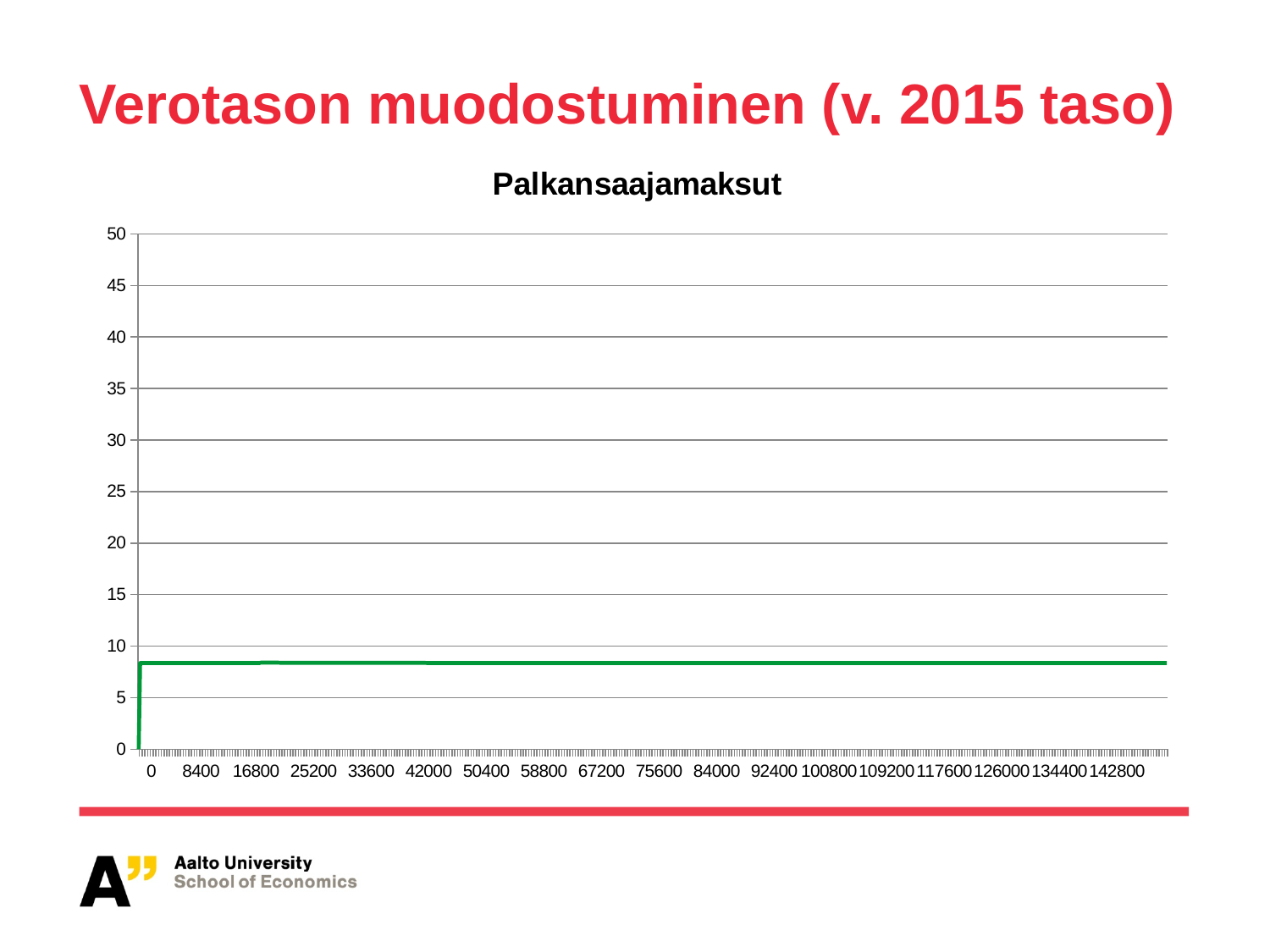
Is the value of the line at 50400 greater or less than 5? greater Is the value of the line at 117600 greater or less than 20? less What is the title of the chart? Palkansaajamaksut Is the value of the line at 142800 greater or less than 15? less What colour is the plotted line in the chart? green What is the highest value shown on the vertical axis? 50 After the initial jump near 0, does the line rise, fall or stay flat as the x-axis values increase? stay flat What kind of chart is shown on the slide? line chart